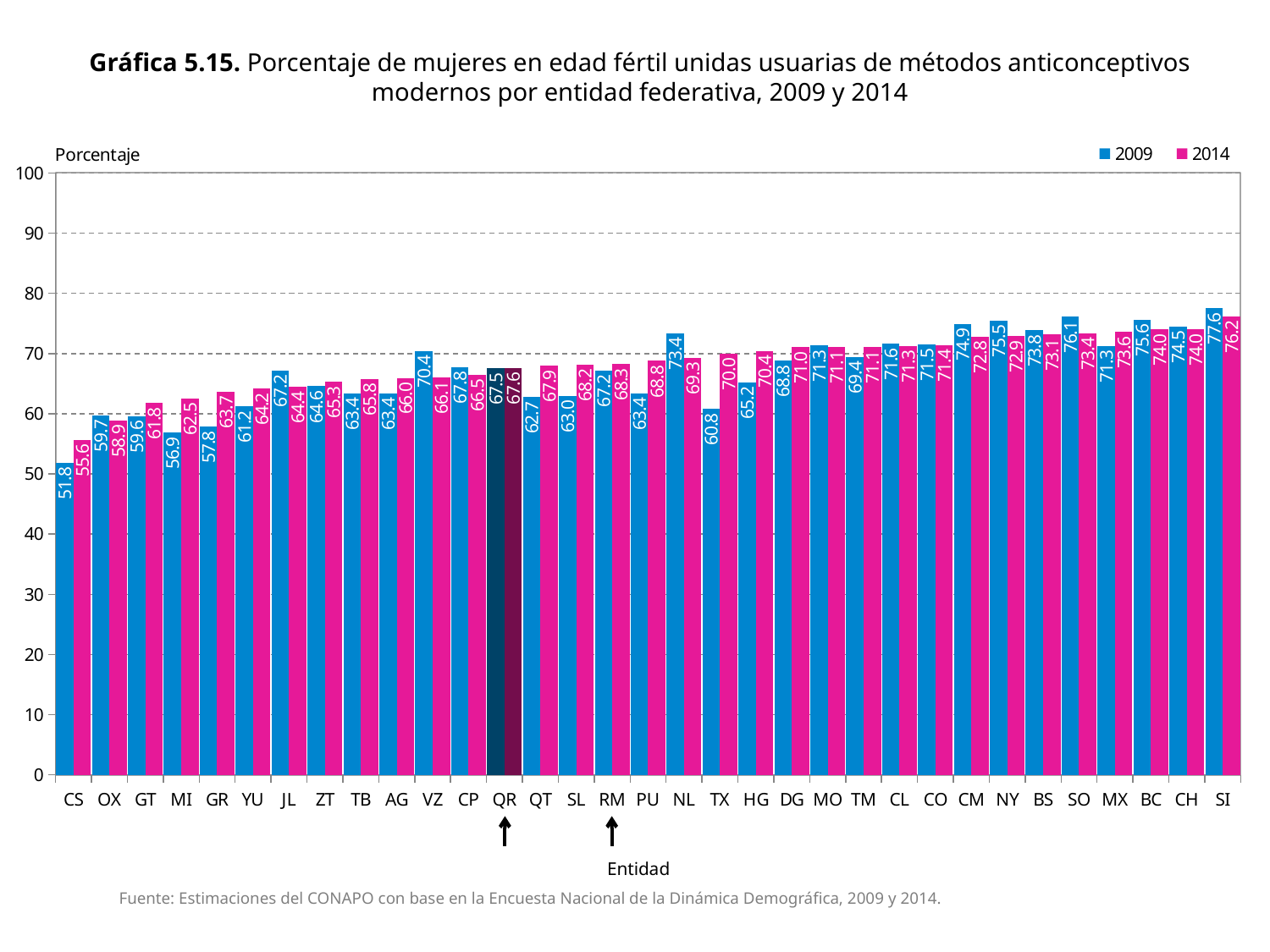
Which entity has the lowest 2009 value? CS Do the 2014 values generally rise or fall from left to right along the x axis? rise What is the 2014 value for QR? 67.6 Which entity has the highest 2014 value? SI What is the 2009 value for NL? 73.4 How many series does the legend list? 2 Is the 2009 value for VZ greater or less than 70? greater What kind of chart is this? bar chart What is the difference between the 2009 and 2014 values for SI? 1.4 What is the 2014 value for CS? 55.6 How many entities are shown on the x axis? 33 For TX, which is larger, the 2009 value or the 2014 value? 2014